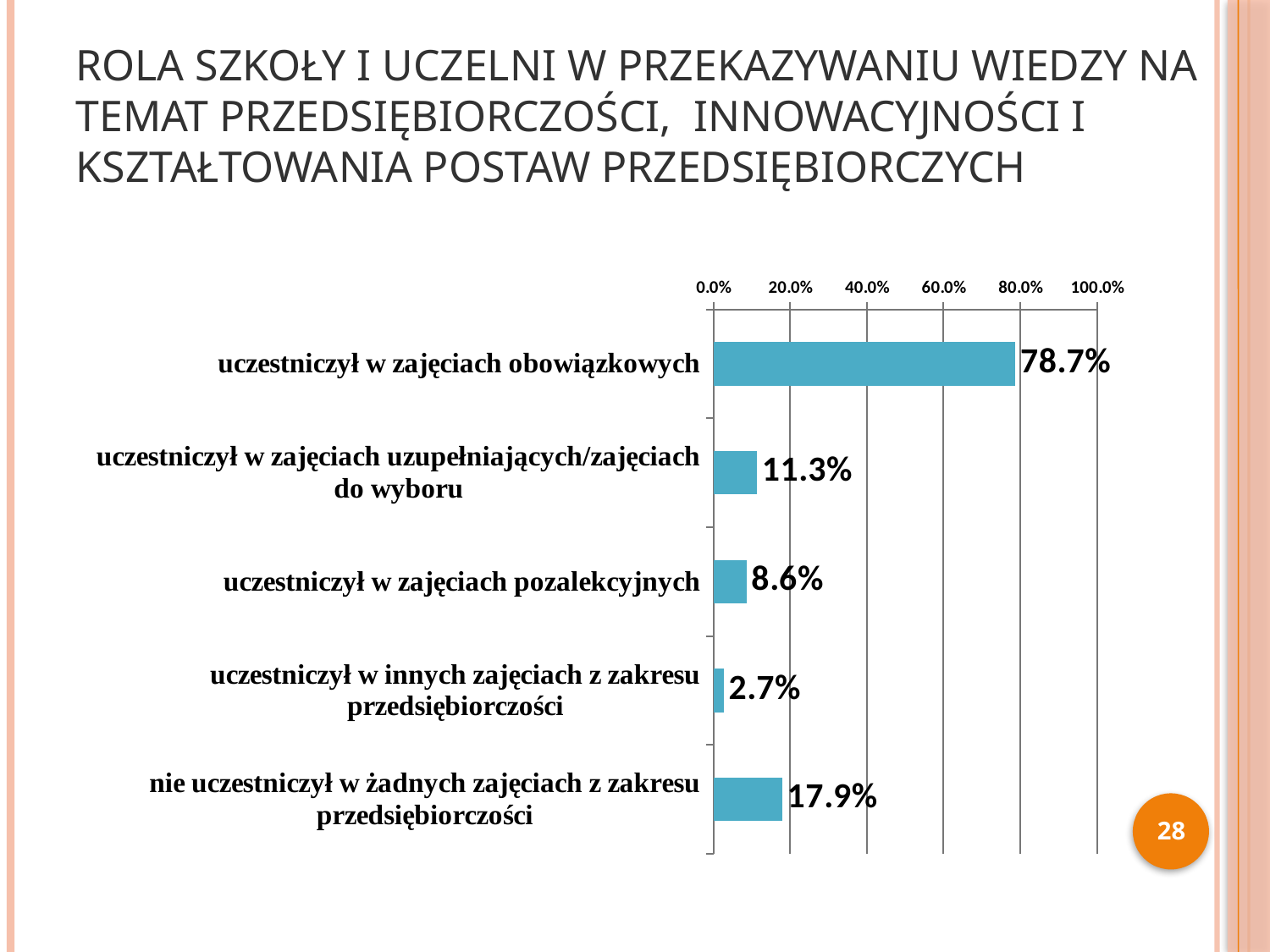
Is the value for "uczestniczył w zajęciach obowiązkowych" greater or less than 60.0%? greater What is the value for "uczestniczył w zajęciach pozalekcyjnych"? 8.6% What is the value for "nie uczestniczył w żadnych zajęciach z zakresu przedsiębiorczości"? 17.9% Which category has the lowest value? uczestniczył w innych zajęciach z zakresu przedsiębiorczości Which category has the highest value? uczestniczył w zajęciach obowiązkowych What kind of chart is shown on the slide? bar chart What is the value for "uczestniczył w zajęciach uzupełniających/zajęciach do wyboru"? 11.3% How many categories are shown in the chart? 5 What is the difference between the values for "uczestniczył w zajęciach obowiązkowych" and "nie uczestniczył w żadnych zajęciach z zakresu przedsiębiorczości"? 60.8% What is the highest value shown on the chart's axis? 100.0% What is the value for "uczestniczył w zajęciach obowiązkowych"? 78.7% Which is larger: the value for "uczestniczył w zajęciach pozalekcyjnych" or for "uczestniczył w zajęciach uzupełniających/zajęciach do wyboru"? uczestniczył w zajęciach uzupełniających/zajęciach do wyboru